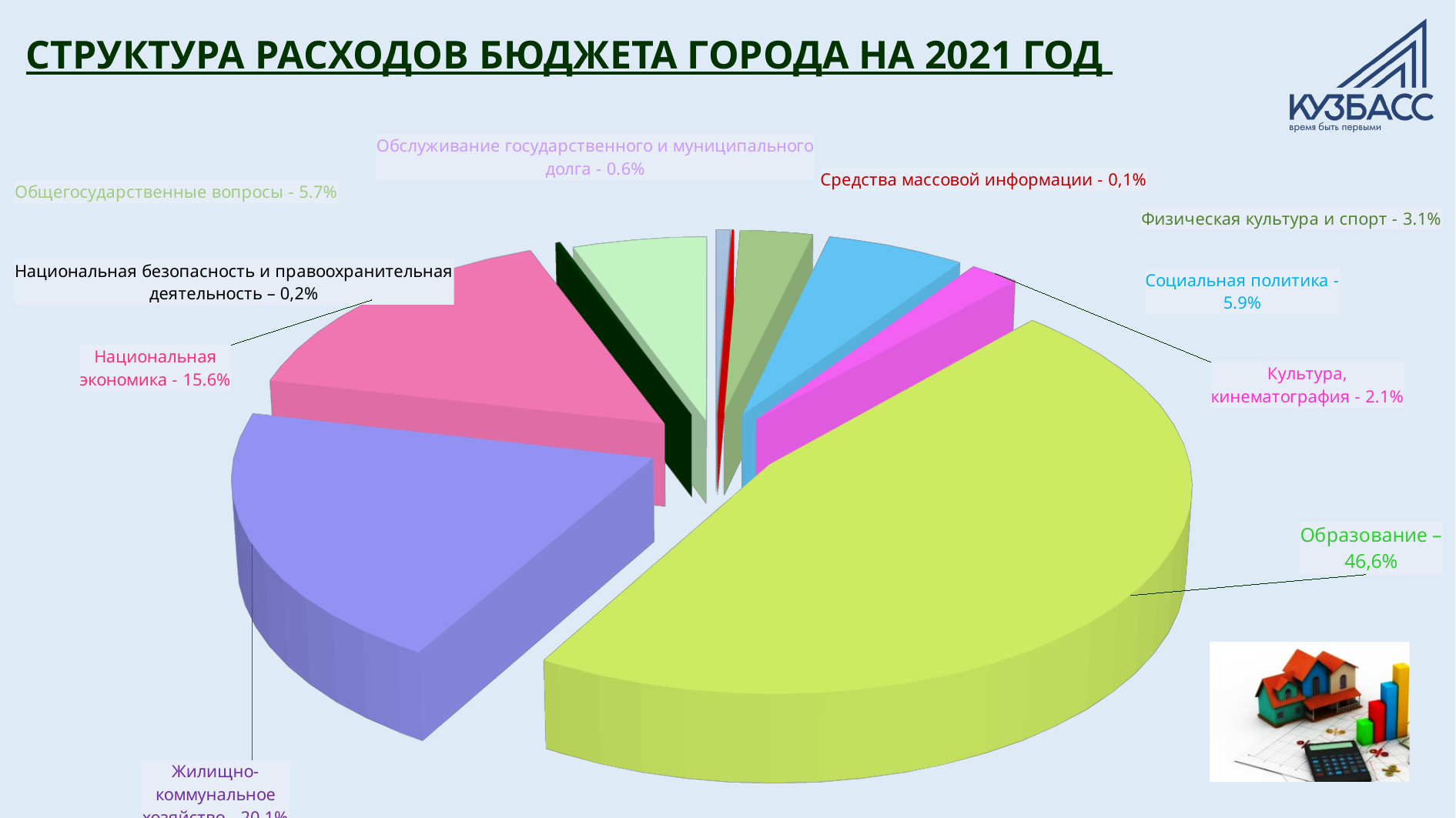
What is the value shown for Обслуживание государственного и муниципального долга? 0.6% What is the difference between the shares for Социальная политика and Общегосударственные вопросы? 0.2% What is the title of the slide? СТРУКТУРА РАСХОДОВ БЮДЖЕТА ГОРОДА НА 2021 ГОД Which is larger, the share for Физическая культура и спорт or for Культура, кинематография? Физическая культура и спорт What kind of chart is shown on the slide? pie chart Which category has the largest share of the budget expenditure? Образование What is the value shown for Национальная экономика? 15.6% What share of the 2021 city budget expenditure goes to Образование? 46,6% How many categories are shown in the pie chart? 10 What is the value shown for Социальная политика? 5.9% What is the value shown for Физическая культура и спорт? 3.1% Which category has the smallest share of the budget expenditure? Средства массовой информации